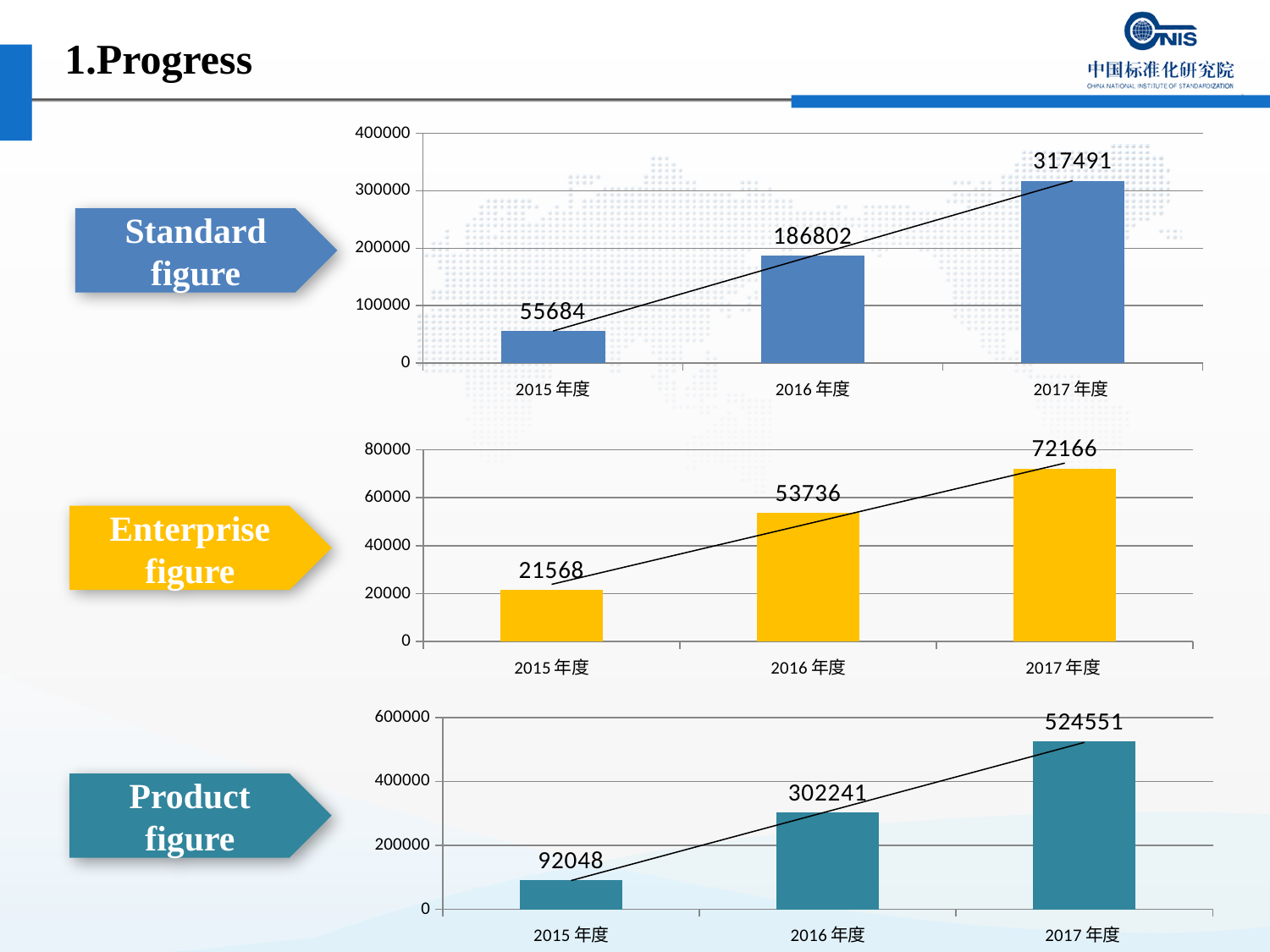
In the Standard figure chart, what is the difference between the 2016年度 and 2015年度 values? 131118 In the Enterprise figure chart, is the value for 2016年度 greater or less than 40000? greater In the Standard figure chart, which year has the lowest value? 2015年度 In the Product figure chart, which year has the highest value? 2017年度 In the Product figure chart, what is the value for 2016年度? 302241 In the Enterprise figure chart, what is the value for 2015年度? 21568 In the Standard figure chart, do the values rise or fall from 2015年度 to 2017年度? rise How many categories are shown in the Product figure chart? 3 In the Enterprise figure chart, what is the difference between the 2017年度 and 2015年度 values? 50598 What kind of chart is the Enterprise figure chart? bar chart In the Standard figure chart, what is the value for 2017年度? 317491 In the Product figure chart, which is larger, the value for 2016年度 or 2017年度? 2017年度